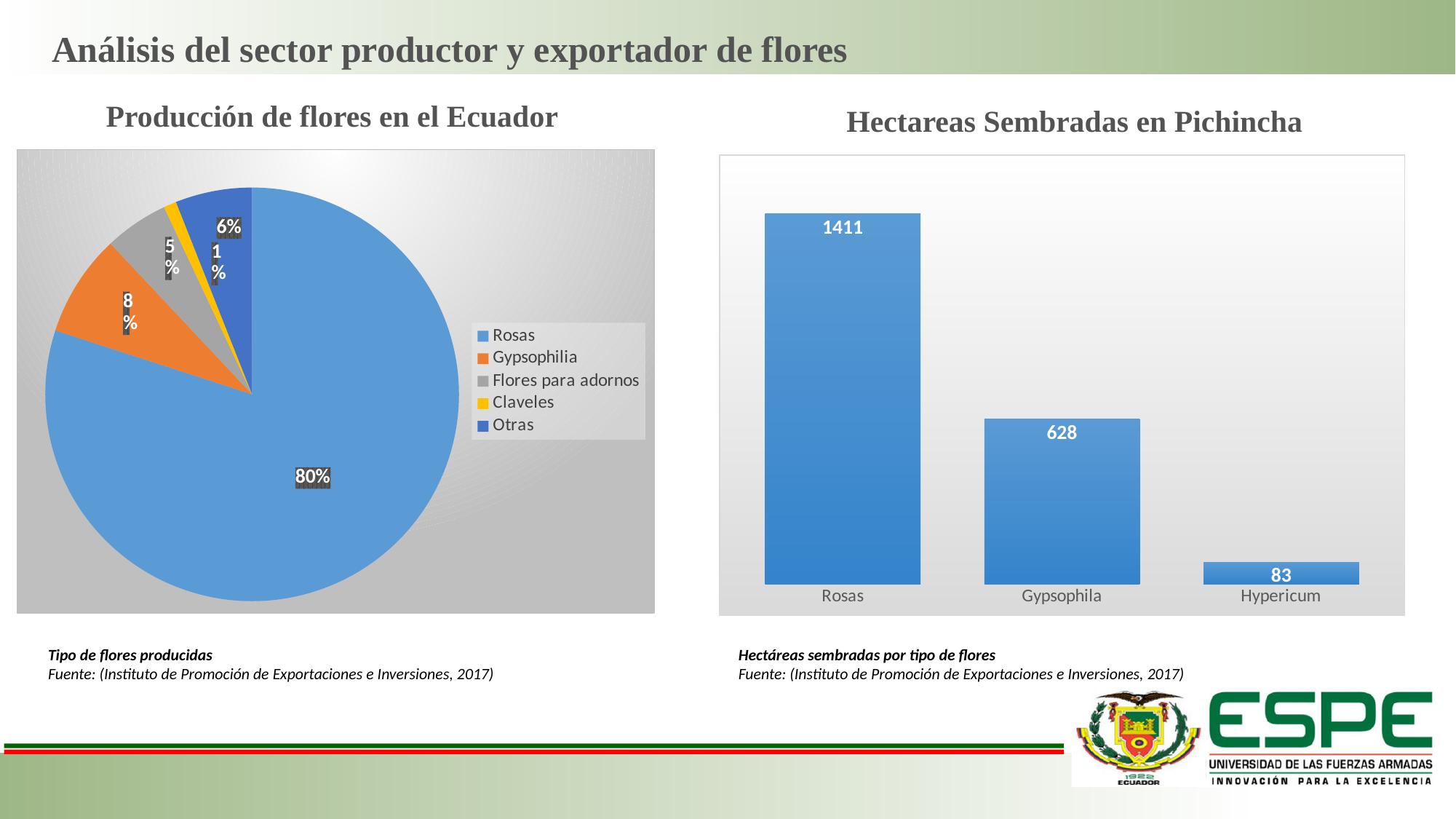
In the 'Producción de flores en el Ecuador' chart, what percentage is shown for Otras? 6% In the 'Producción de flores en el Ecuador' chart, what share of the pie does Rosas have? 80% What kind of chart is 'Producción de flores en el Ecuador'? Pie chart In the 'Hectareas Sembradas en Pichincha' chart, how many categories are plotted? 3 What kind of chart is 'Hectareas Sembradas en Pichincha'? Bar chart In the 'Producción de flores en el Ecuador' chart, what percentage is shown for Gypsophilia? 8% In the 'Hectareas Sembradas en Pichincha' chart, which category has the highest value? Rosas In the 'Producción de flores en el Ecuador' chart, how many categories does the legend list? 5 In the 'Hectareas Sembradas en Pichincha' chart, what is the difference between Rosas and Gypsophila? 783 In the 'Hectareas Sembradas en Pichincha' chart, what is the value for Gypsophila? 628 In the 'Producción de flores en el Ecuador' chart, which category has the smallest slice? Claveles In the 'Hectareas Sembradas en Pichincha' chart, what is the value for Hypericum? 83